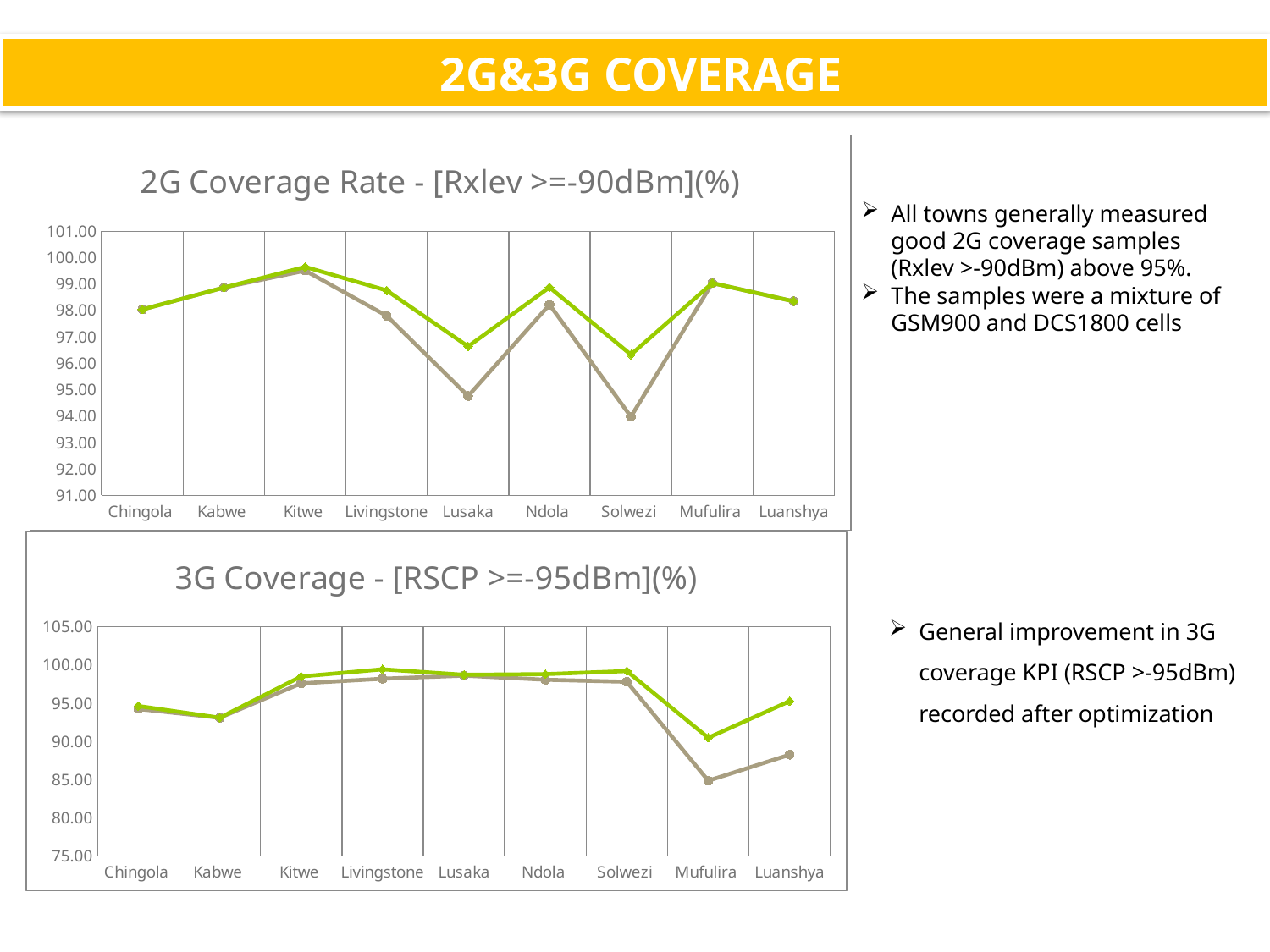
How many lines are plotted on the '3G Coverage - [RSCP >=-95dBm](%)' chart? 2 In the '3G Coverage' chart, is the grey line's value for Mufulira greater or less than 90.00? less What is the title of the bottom chart on the slide? 3G Coverage - [RSCP >=-95dBm](%) In the '2G Coverage Rate' chart, at Solwezi, which line has the higher value, the green line or the grey line? the green line In the '2G Coverage Rate' chart, is the grey line's value for Solwezi greater or less than 95.00? less How many towns are shown on the x axis of the '2G Coverage Rate' chart? 9 In the '3G Coverage' chart, which town has the lowest value on the grey line? Mufulira In the '2G Coverage Rate' chart, which town has the lowest value on the grey line? Solwezi What type of chart is the top chart, '2G Coverage Rate - [Rxlev >=-90dBm](%)'? line chart In the '2G Coverage Rate' chart, is the green line's value for Lusaka greater or less than 96.00? greater In the '2G Coverage Rate' chart, which town has the highest value on the green line? Kitwe